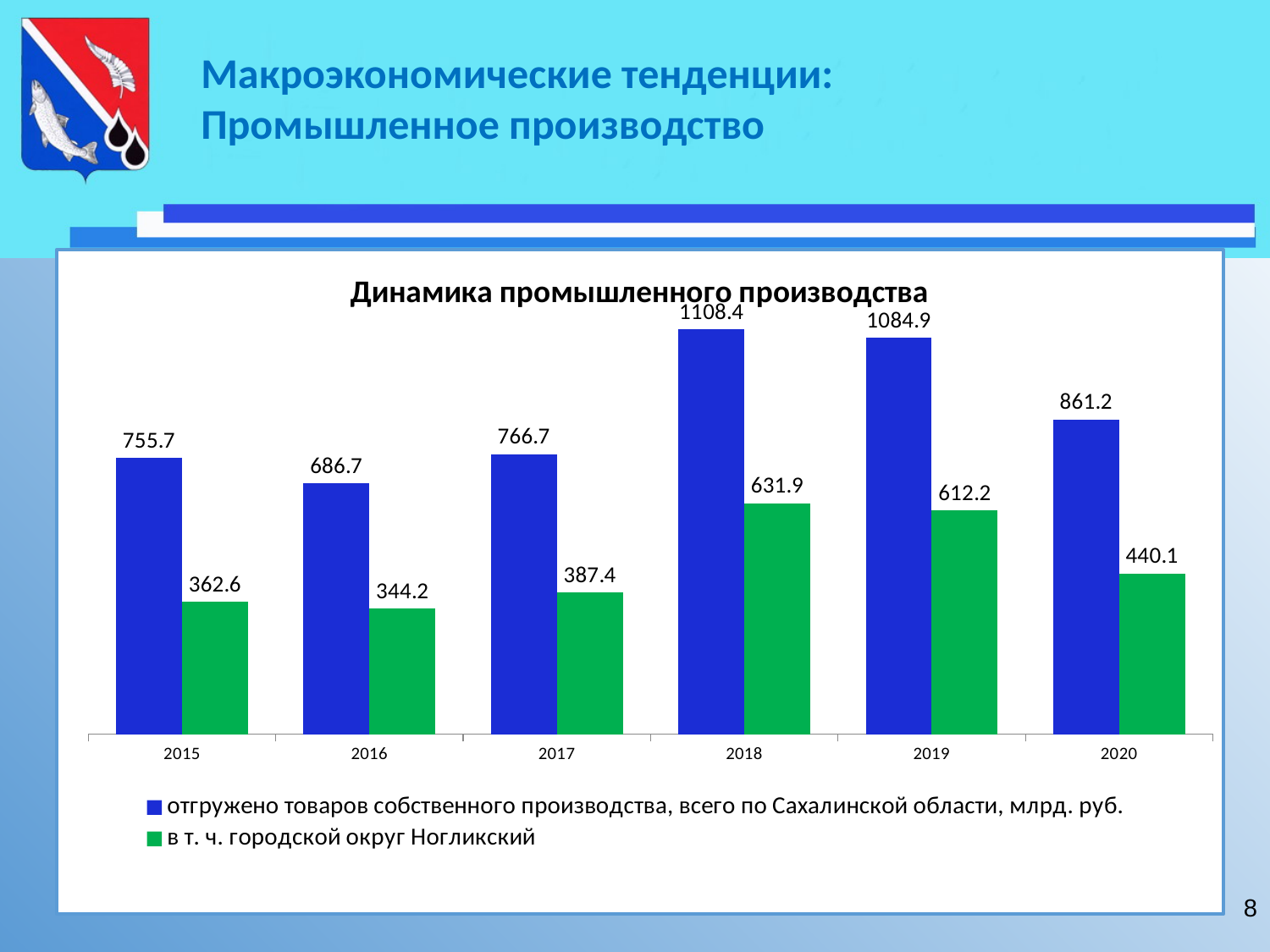
Which year has the highest value in the series 'в т. ч. городской округ Ногликский'? 2018 How many years are shown on the x axis? 6 Which year has the lowest value in the series 'отгружено товаров собственного производства, всего по Сахалинской области, млрд. руб.'? 2016 Which is larger: the 2017 value or the 2015 value in the series 'в т. ч. городской округ Ногликский'? 2017 What is the difference between the 2019 and 2020 values in the series 'отгружено товаров собственного производства, всего по Сахалинской области, млрд. руб.'? 223.7 How many series does the legend list? 2 Does the series 'в т. ч. городской округ Ногликский' rise or fall from 2017 to 2018? rise What is the title of the chart? Динамика промышленного производства What kind of chart is shown? bar chart What is the value for 2020 in the series 'в т. ч. городской округ Ногликский'? 440.1 What is the value for 2018 in the series 'отгружено товаров собственного производства, всего по Сахалинской области, млрд. руб.'? 1108.4 What is the value for 2016 in the series 'отгружено товаров собственного производства, всего по Сахалинской области, млрд. руб.'? 686.7